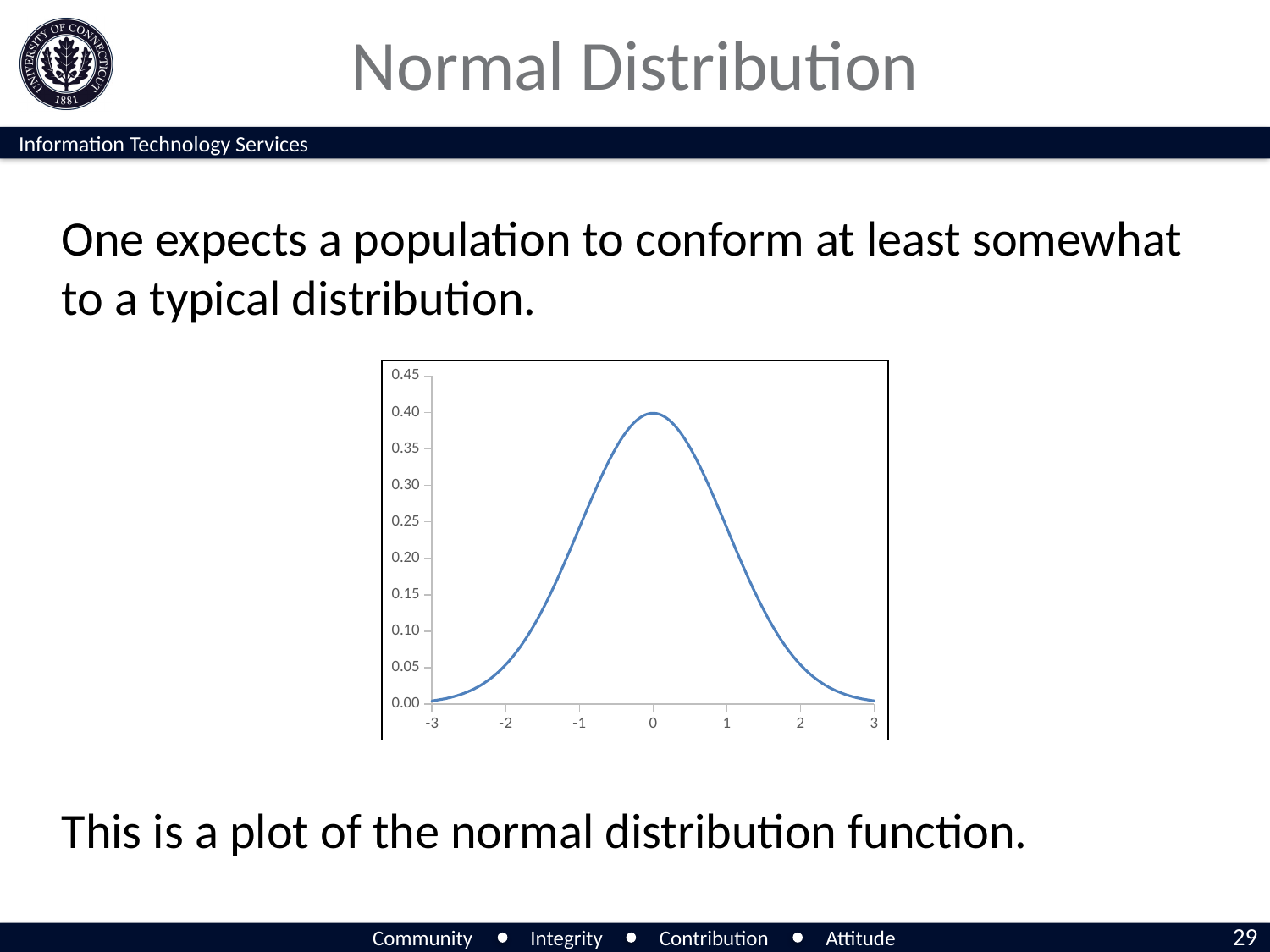
Does the curve rise or fall as x goes from -3 to 0? rise Is the value of the curve at x = 3 greater or less than 0.05? less Is the value of the curve at x = 1 greater or less than 0.30? less Which is larger, the value of the curve at x = -1 or at x = 2? x = -1 At which x value does the curve reach its highest point? 0 What is the highest tick value shown on the y axis? 0.45 Is the value of the curve at x = 2 greater or less than 0.10? less How many tick labels are shown on the x axis? 7 What kind of chart is shown on the slide? line chart Does the curve rise or fall as x goes from 0 to 3? fall